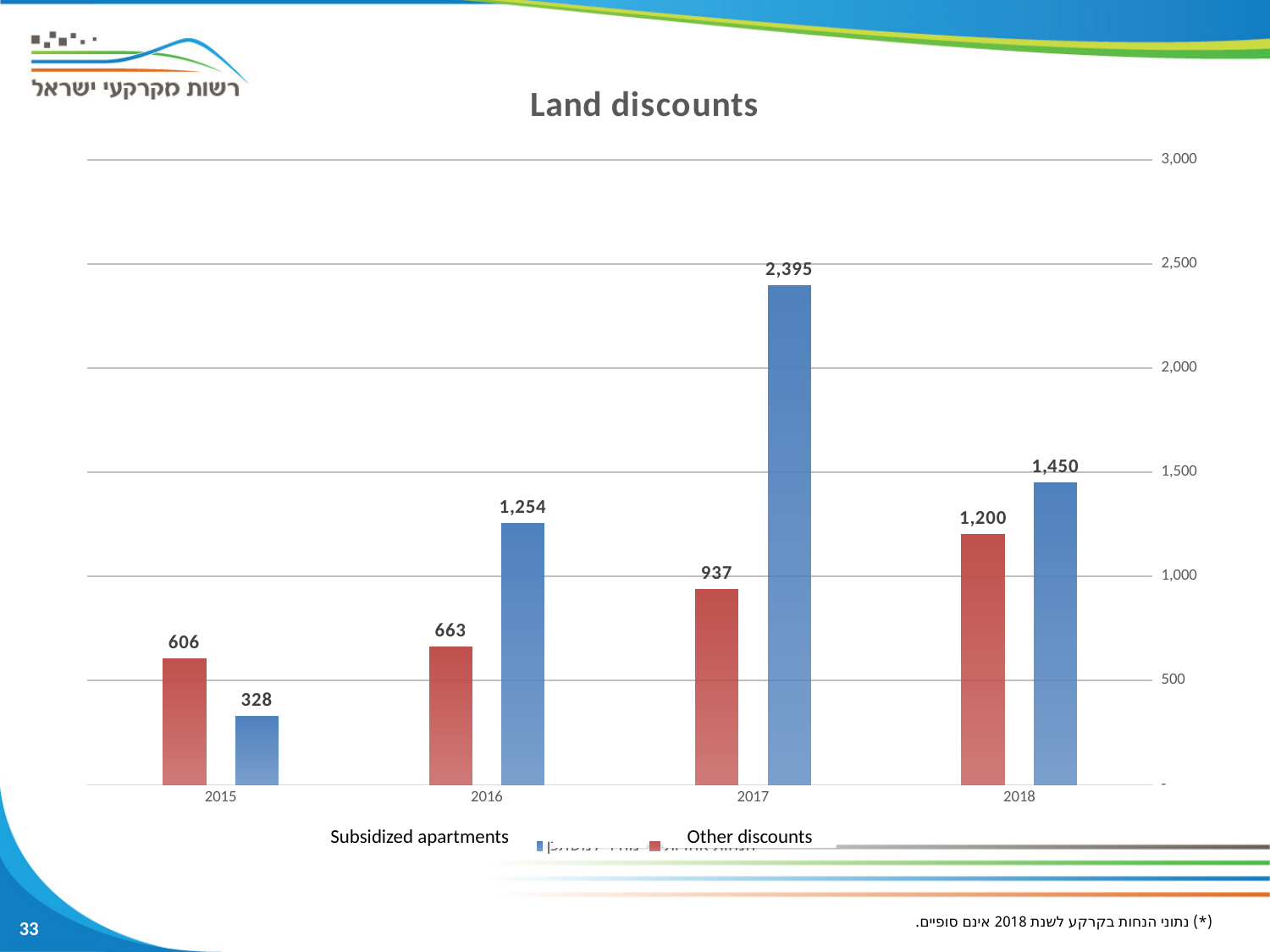
How many years are shown on the x axis? 4 Do the Other discounts values rise or fall from 2015 to 2018? Rise In 2015, which is larger: Subsidized apartments or Other discounts? Other discounts What kind of chart is shown on the slide? Bar chart What is the value for Other discounts in 2015? 606 What is the difference between Subsidized apartments and Other discounts in 2016? 591 What is the value for Other discounts in 2018? 1,200 What is the value for Subsidized apartments in 2015? 328 How many series does the legend list? 2 In which year is the Other discounts value lowest? 2015 What is the value for Subsidized apartments in 2017? 2,395 In which year is the Subsidized apartments value highest? 2017